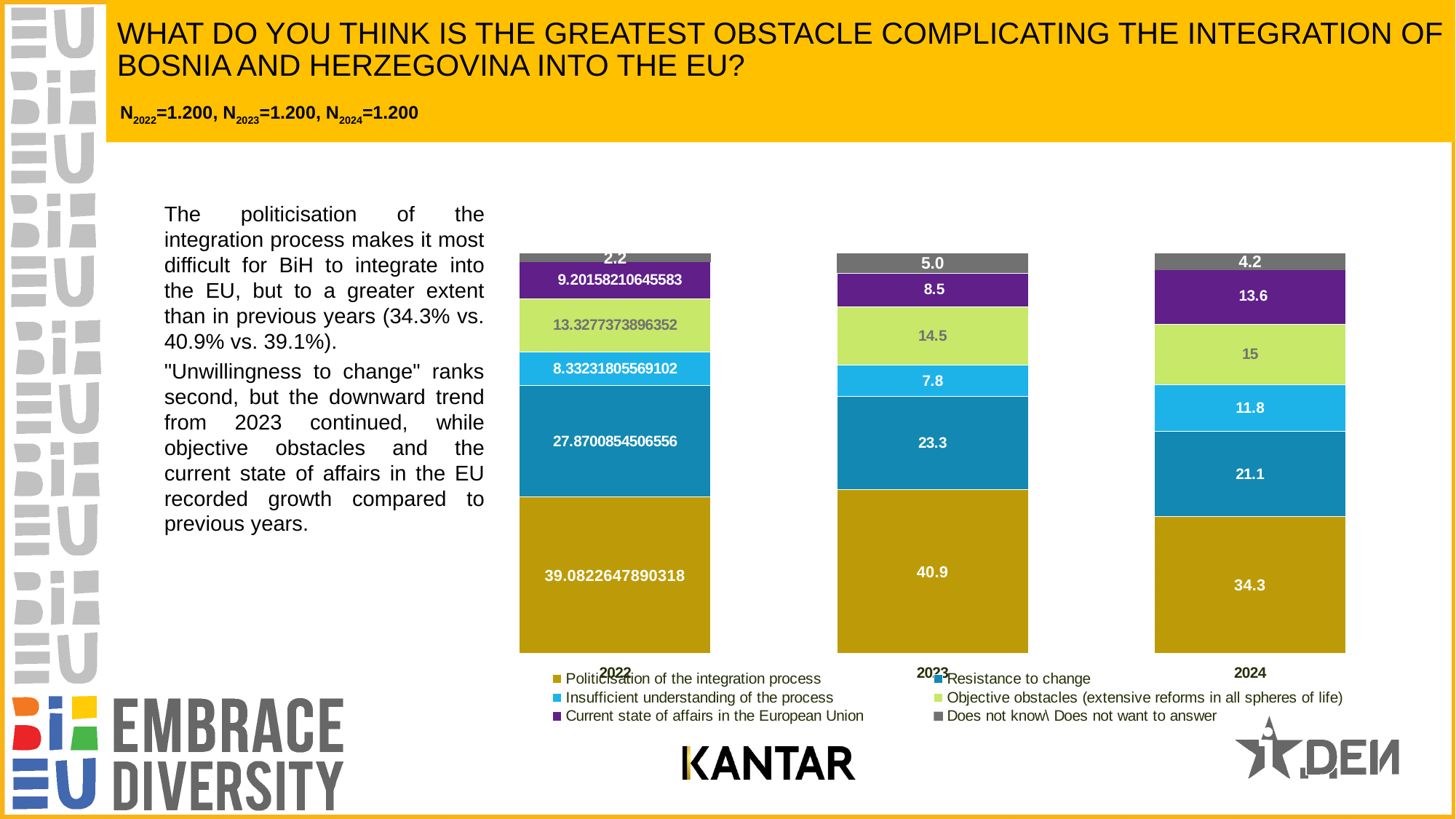
What is the value for 'Does not know\ Does not want to answer' in 2023? 5.0 What is the value for 'Resistance to change' in 2023? 23.3 Does the value for 'Resistance to change' rise or fall from 2022 to 2024? Fall Which category has the highest value in the 2024 bar? Politicisation of the integration process How many years (bars) does the chart show? 3 How many series does the legend list? 6 Is the value for 'Insufficient understanding of the process' larger in 2023 or in 2024? 2024 Which category has the lowest value in the 2024 bar? Does not know\ Does not want to answer What is the difference between the 'Politicisation of the integration process' values for 2023 and 2024? 6.6 What is the value for 'Politicisation of the integration process' in 2024? 34.3 What is the value for 'Current state of affairs in the European Union' in 2024? 13.6 What kind of chart is shown on the slide? Stacked bar chart